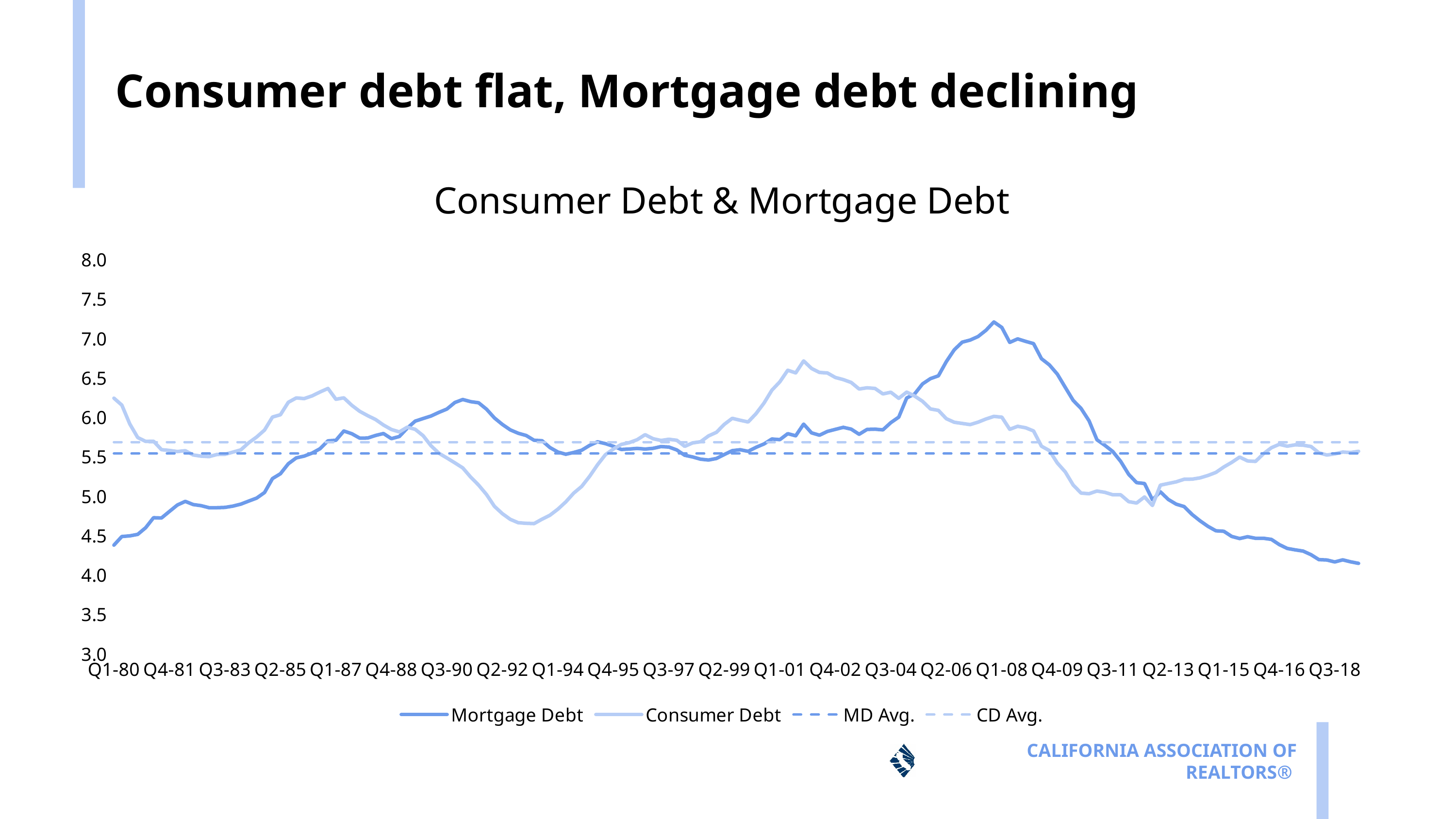
What is the title of the chart? Consumer Debt & Mortgage Debt What kind of chart is shown on the slide? line chart Is the value of Mortgage Debt at Q3-18 greater or less than 4.5? less Is the value of Mortgage Debt at Q1-80 greater or less than 5.0? less How many series does the legend list? 4 Which series reaches the highest value on the chart? Mortgage Debt At Q3-18, which is larger: Mortgage Debt or Consumer Debt? Consumer Debt Which two legend entries are drawn as dashed lines? MD Avg. and CD Avg. Is the value of Mortgage Debt at Q1-08 greater or less than 7.0? greater At Q1-80, which is larger: Mortgage Debt or Consumer Debt? Consumer Debt Does Mortgage Debt rise or fall from Q1-08 to Q3-18? fall